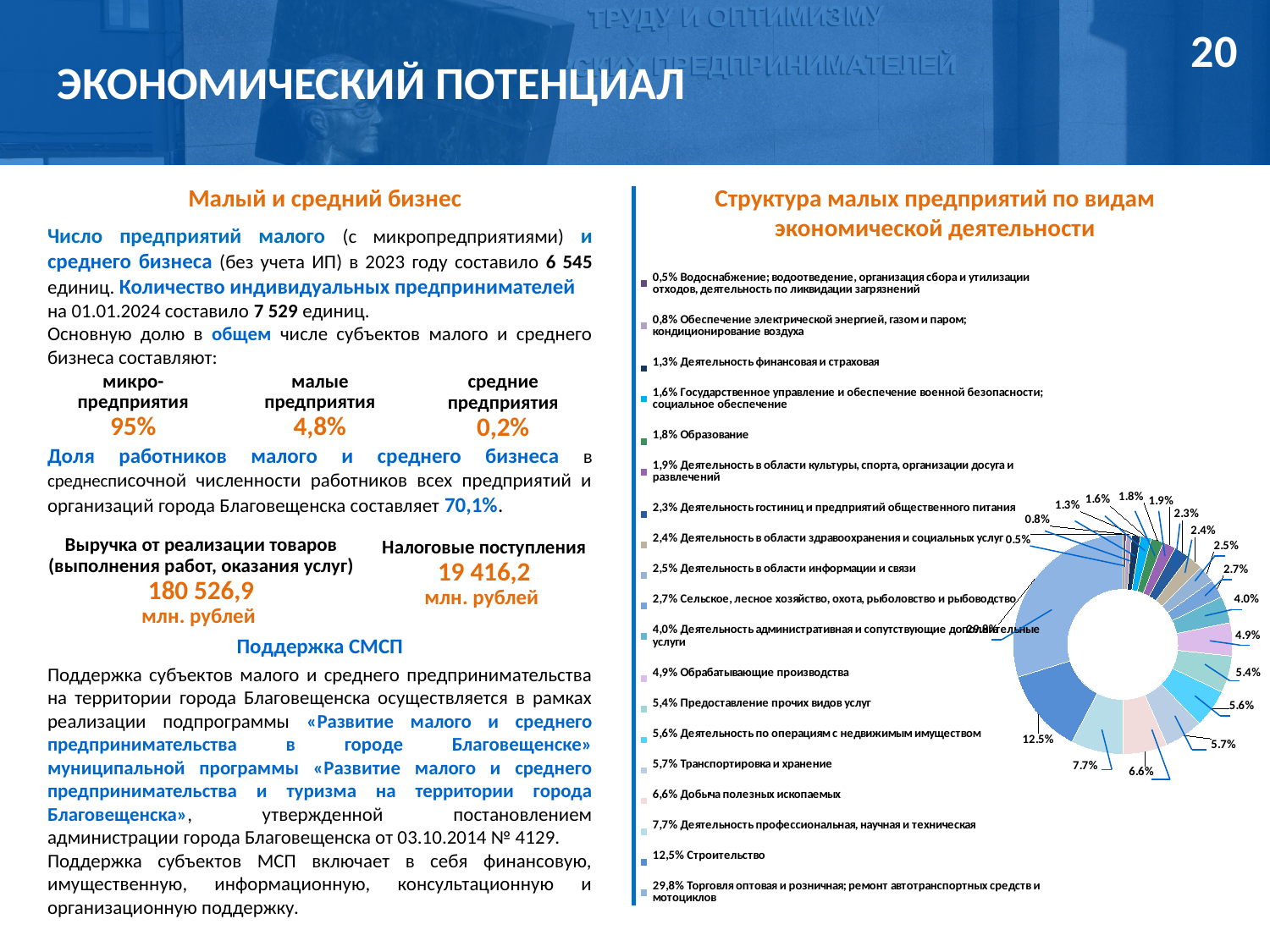
In the chart 'Структура малых предприятий по видам экономической деятельности', what is the value for 'Образование'? 1,8% In the chart 'Структура малых предприятий по видам экономической деятельности', what is the value for 'Обрабатывающие производства'? 4,9% What kind of chart is shown under the title 'Структура малых предприятий по видам экономической деятельности'? doughnut chart In the chart 'Структура малых предприятий по видам экономической деятельности', which category has the smallest share? Водоснабжение; водоотведение, организация сбора и утилизации отходов, деятельность по ликвидации загрязнений In the chart 'Структура малых предприятий по видам экономической деятельности', what is the difference between the shares of 'Строительство' and 'Деятельность профессиональная, научная и техническая'? 4,8 percentage points In the chart 'Структура малых предприятий по видам экономической деятельности', what is the value for 'Добыча полезных ископаемых'? 6,6% In the chart 'Структура малых предприятий по видам экономической деятельности', what share does 'Строительство' have? 12,5% In the chart 'Структура малых предприятий по видам экономической деятельности', what is the value for 'Транспортировка и хранение'? 5,7% In the chart 'Структура малых предприятий по видам экономической деятельности', which category has the largest share? Торговля оптовая и розничная; ремонт автотранспортных средств и мотоциклов In the chart 'Структура малых предприятий по видам экономической деятельности', which is larger: 'Строительство' or 'Деятельность профессиональная, научная и техническая'? Строительство In the chart 'Структура малых предприятий по видам экономической деятельности', what is the difference between the shares of 'Торговля оптовая и розничная; ремонт автотранспортных средств и мотоциклов' and 'Строительство'? 17,3 percentage points In the chart 'Структура малых предприятий по видам экономической деятельности', how many categories are shown? 19